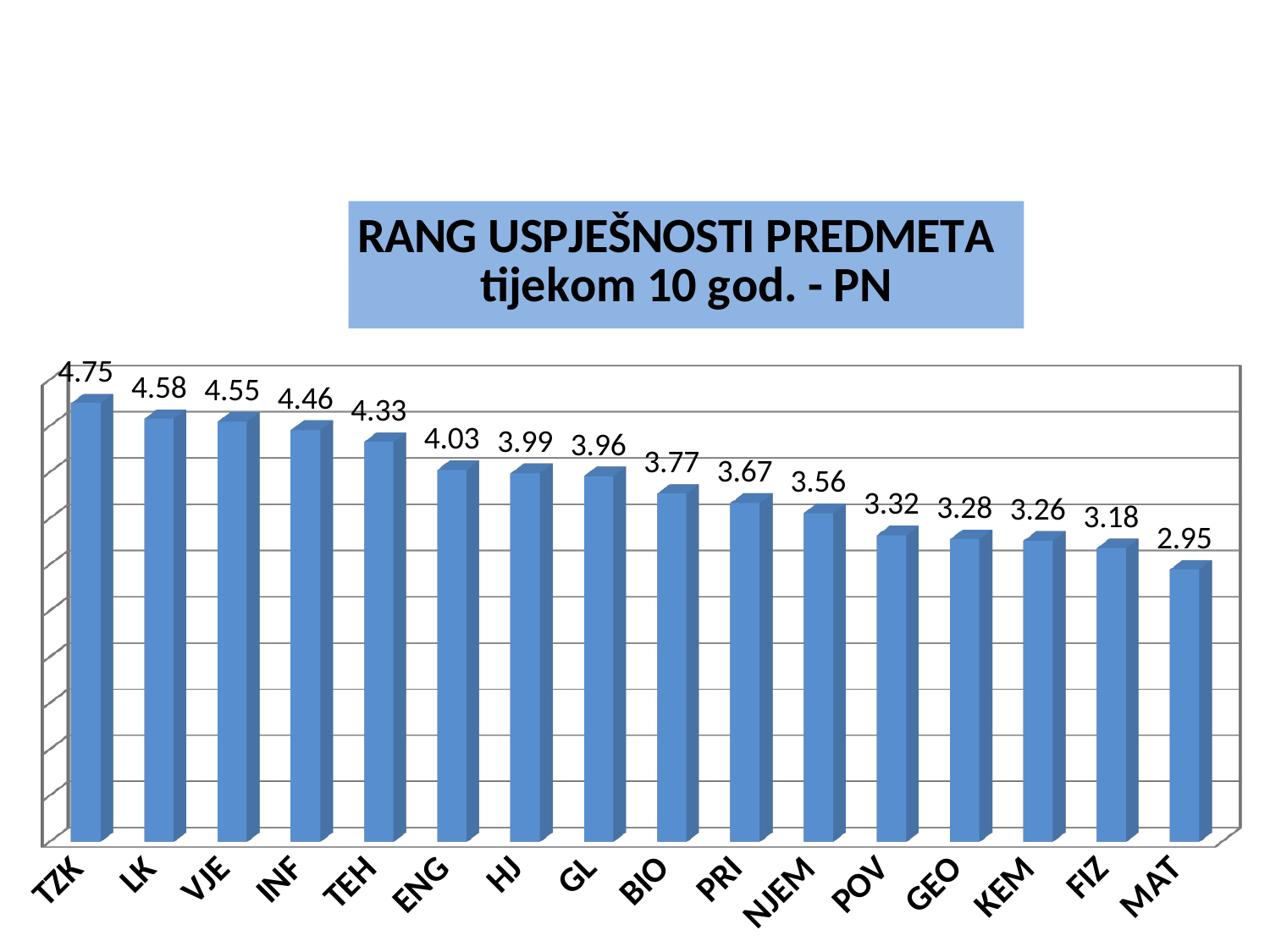
What is the value for ENG? 4.03 How many categories are shown on the x axis? 16 Do the values rise or fall from left to right along the x axis? fall What is the difference between the values for INF and TEH? 0.13 Which category has the highest value? TZK What is the title of the chart? RANG USPJEŠNOSTI PREDMETA tijekom 10 god. - PN Which category has the lowest value? MAT What is the value for NJEM? 3.56 What is the difference between the values for TZK and MAT? 1.80 Which is larger, the value for BIO or the value for POV? BIO What is the value for TZK? 4.75 What kind of chart is shown on the slide? bar chart